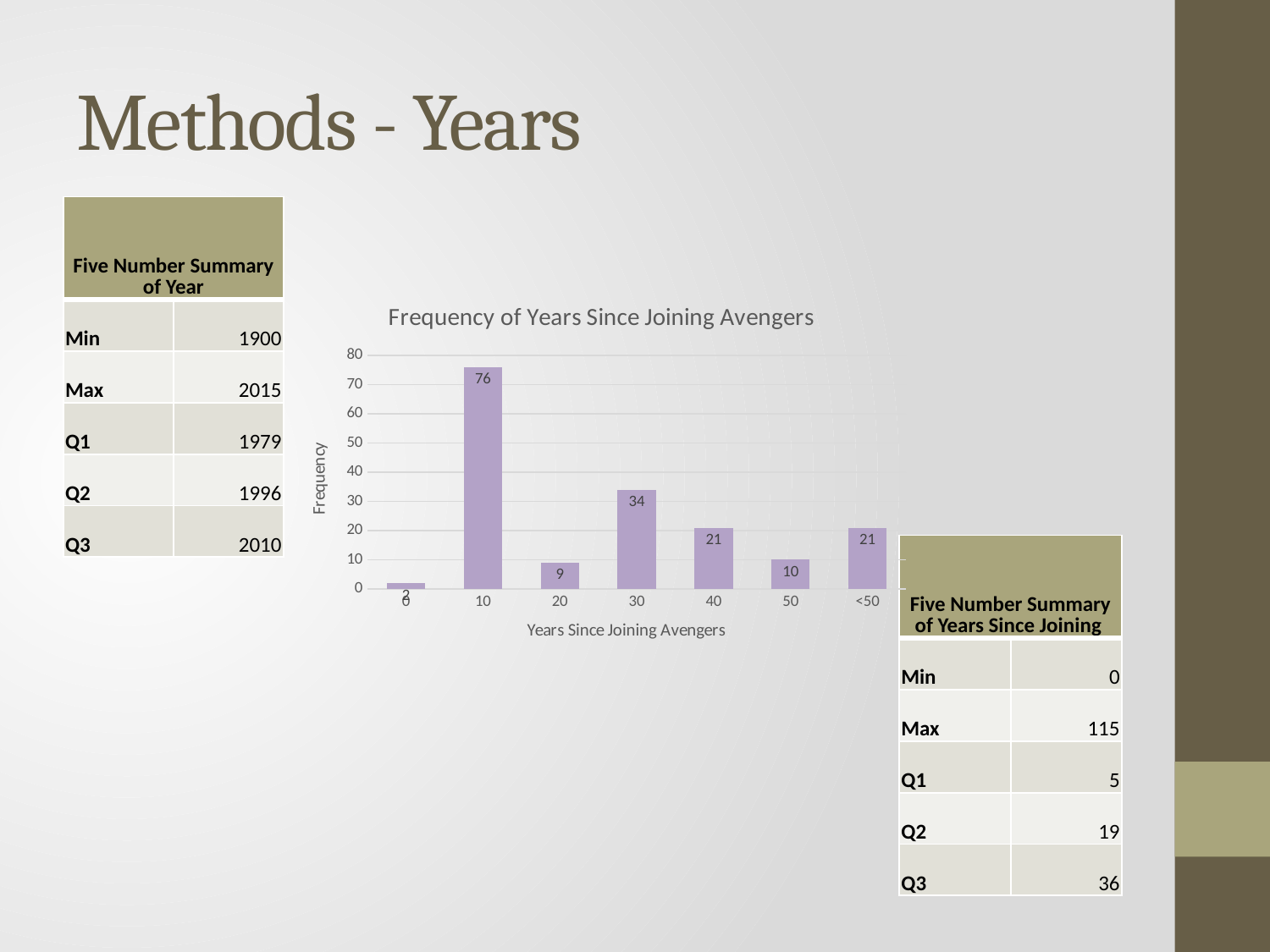
In the chart 'Frequency of Years Since Joining Avengers', what is the frequency for the 30 category? 34 In the chart 'Frequency of Years Since Joining Avengers', what is the frequency for the 50 category? 10 In the chart 'Frequency of Years Since Joining Avengers', which category has the highest frequency? 10 What kind of chart is 'Frequency of Years Since Joining Avengers'? bar chart In the chart 'Frequency of Years Since Joining Avengers', is the frequency for the 10 category greater or less than 70? greater In the chart 'Frequency of Years Since Joining Avengers', what is the frequency for the 20 category? 9 What is the x-axis title of the chart 'Frequency of Years Since Joining Avengers'? Years Since Joining Avengers In the chart 'Frequency of Years Since Joining Avengers', what is the difference between the frequency for 10 and the frequency for 30? 42 How many categories are shown on the x axis of the chart 'Frequency of Years Since Joining Avengers'? 7 In the chart 'Frequency of Years Since Joining Avengers', what is the frequency for the 10 category? 76 In the chart 'Frequency of Years Since Joining Avengers', what is the frequency for the 40 category? 21 In the chart 'Frequency of Years Since Joining Avengers', which has the larger frequency, the 20 category or the 50 category? 50